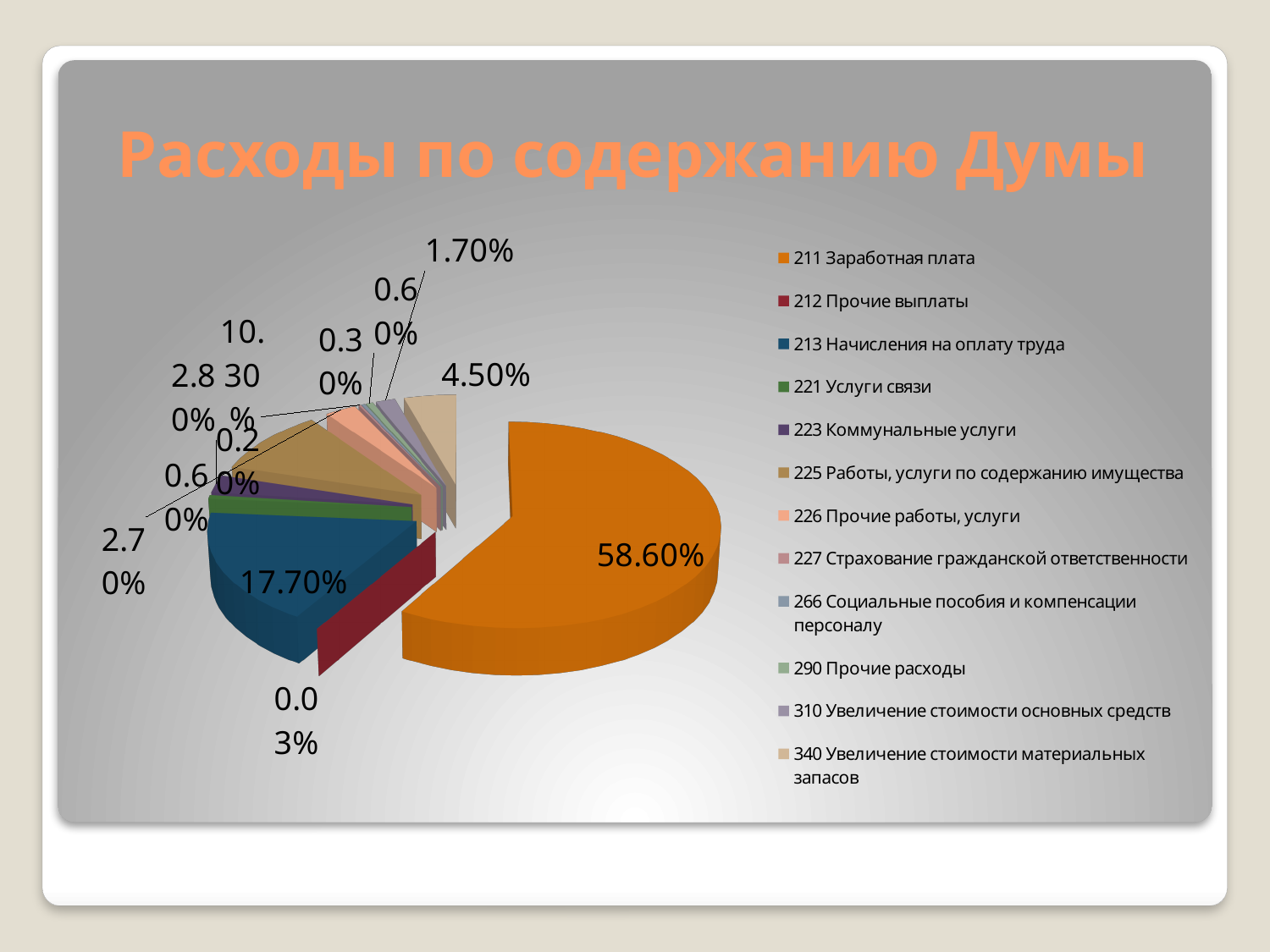
Which is larger: the slice for 211 Заработная плата or the slice for 213 Начисления на оплату труда? 211 Заработная плата What share of the pie does 310 Увеличение стоимости основных средств take? 1.70% Is the share for 211 Заработная плата greater or less than 50%? greater What share of the pie does 213 Начисления на оплату труда take? 17.70% Which legend entry is shown in orange? 211 Заработная плата What is the difference between the shares of 211 Заработная плата and 213 Начисления на оплату труда? 40.90% Which category has the largest slice of the pie? 211 Заработная плата What share of the pie does 211 Заработная плата take? 58.60% What is the title of the chart on the slide? Расходы по содержанию Думы How many categories does the legend of the pie chart list? 12 What type of chart is shown on the slide? pie chart